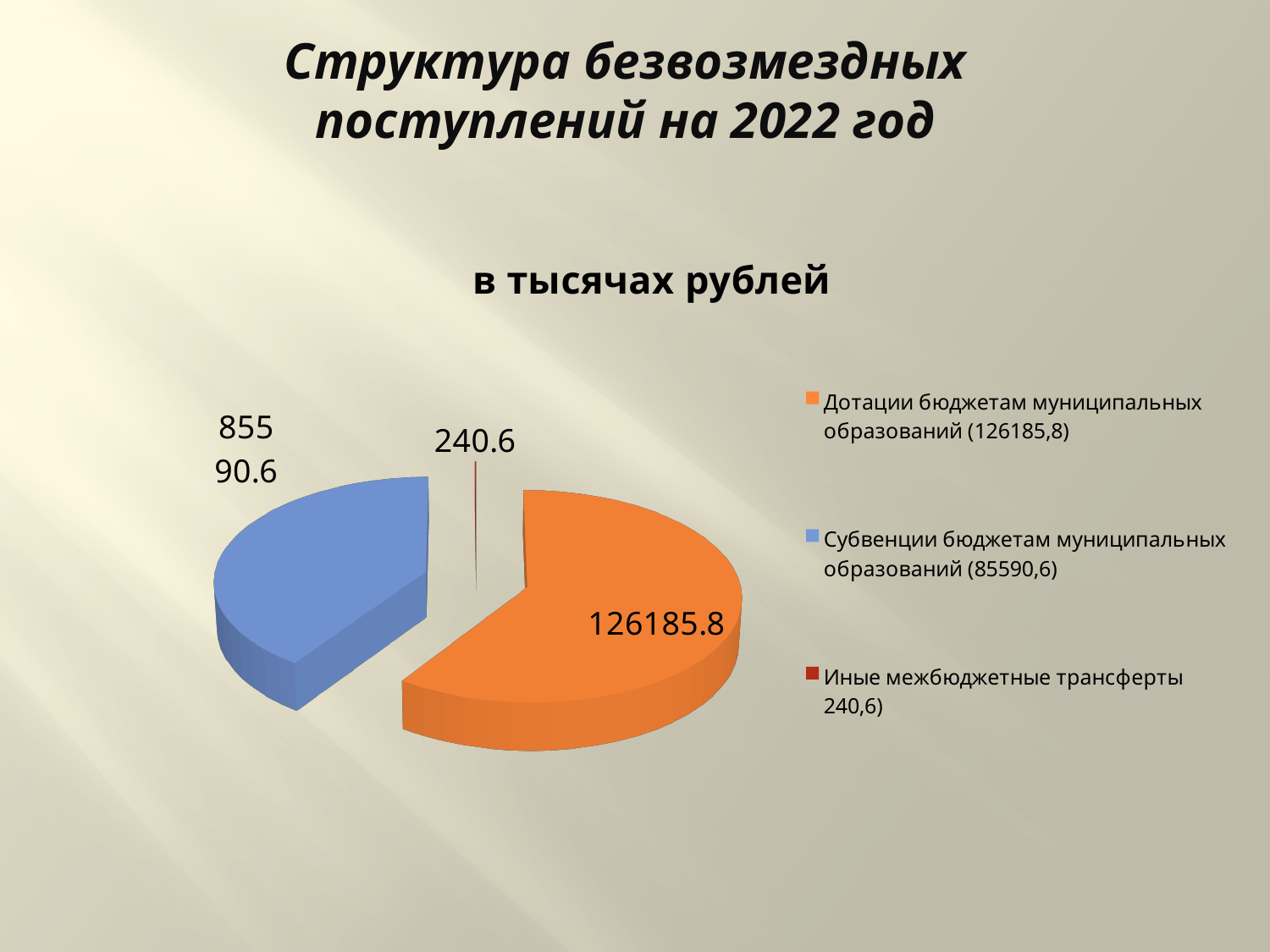
Which category has the largest slice of the pie? Дотации бюджетам муниципальных образований How many entries does the legend list? 3 What is the title of the chart? в тысячах рублей What is the difference between the values for Дотации бюджетам муниципальных образований and Субвенции бюджетам муниципальных образований? 40595.2 Which is larger, Дотации бюджетам муниципальных образований or Субвенции бюджетам муниципальных образований? Дотации бюджетам муниципальных образований What is the value for Дотации бюджетам муниципальных образований? 126185.8 What colour is the slice for Субвенции бюджетам муниципальных образований? blue What is the value for Субвенции бюджетам муниципальных образований? 85590.6 How many slices does the pie chart have? 3 Which category has the smallest slice of the pie? Иные межбюджетные трансферты What is the value for Иные межбюджетные трансферты? 240.6 What kind of chart is shown on the slide? pie chart